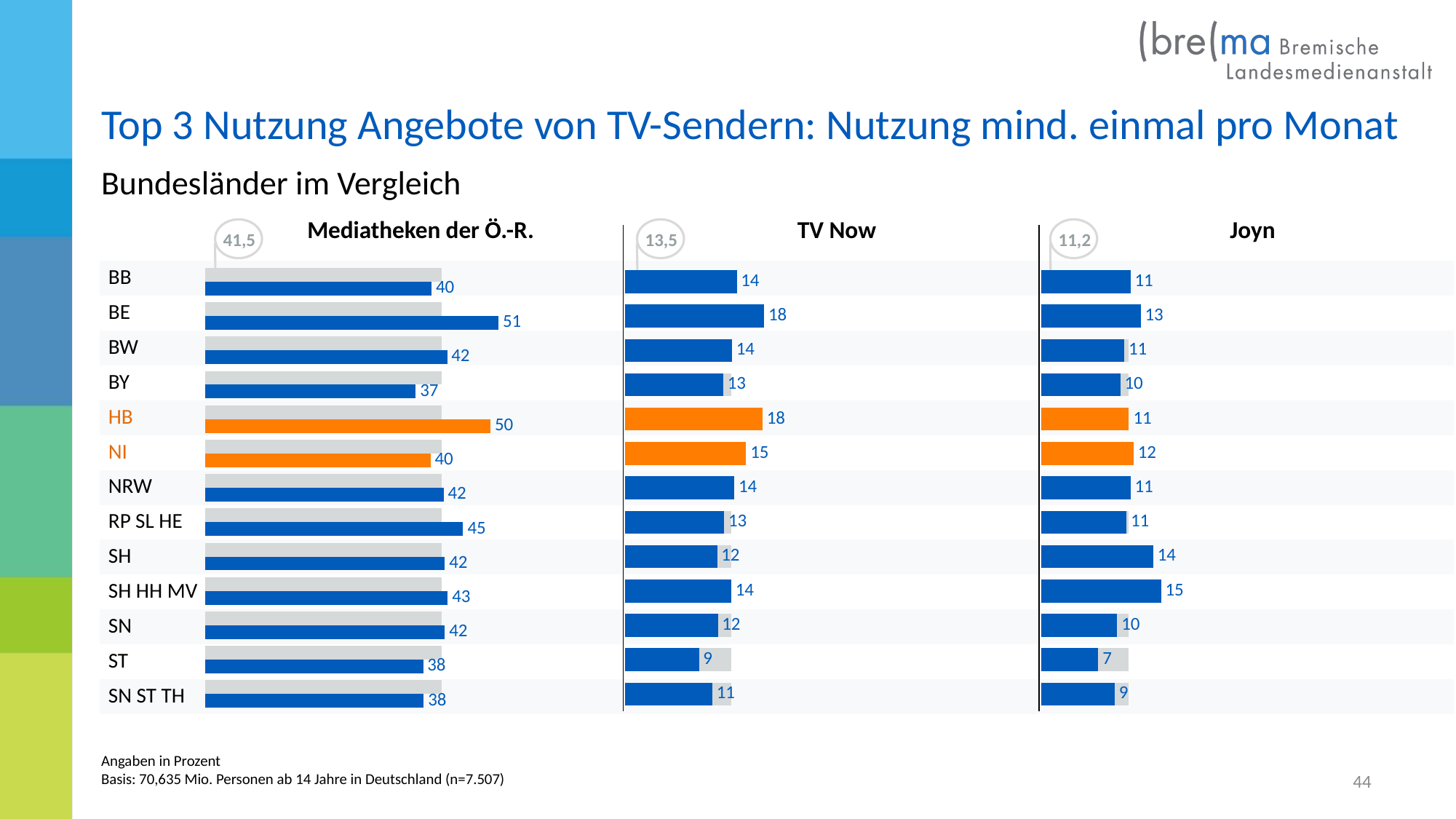
In the 'TV Now' chart, what is the difference between the values for HB and ST? 9 In the 'Joyn' chart, which category has the highest value? SH HH MV In the 'Mediatheken der Ö.-R.' chart, what is the value for BE? 51 In the 'Joyn' chart, what is the value for SH HH MV? 15 In the 'Mediatheken der Ö.-R.' chart, what is the difference between the values for BE and BY? 14 What reference value is shown in the circle at the top of the 'Mediatheken der Ö.-R.' chart? 41,5 In the 'Mediatheken der Ö.-R.' chart, which category has the lowest value? BY What kind of chart is the 'TV Now' chart? bar chart In the 'Joyn' chart, which is larger, the value for NI or the value for BY? NI In the 'TV Now' chart, what is the value for HB? 18 In the 'TV Now' chart, which category has the lowest value? ST How many categories are shown in the 'Joyn' chart? 13